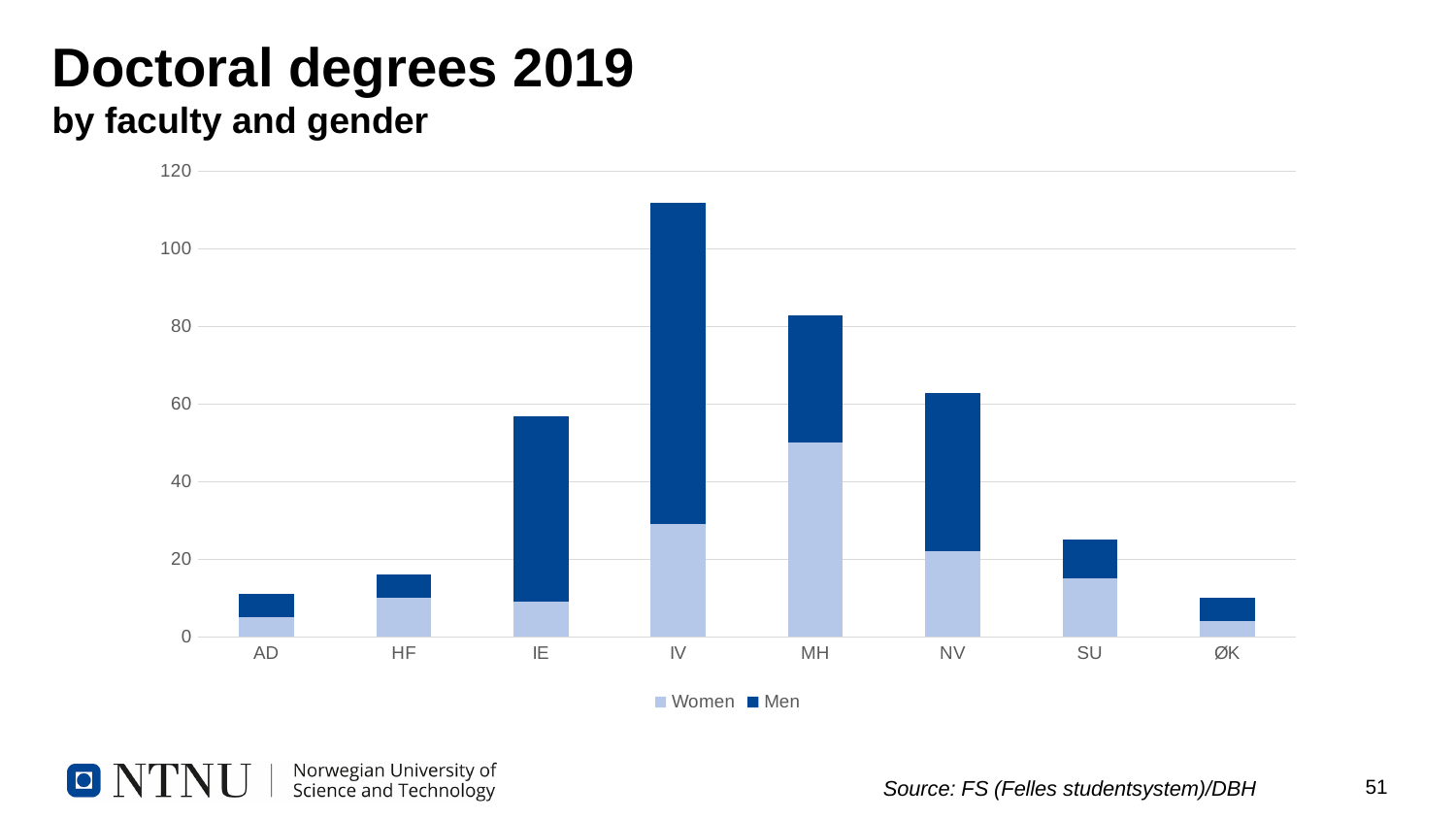
How many series does the legend list? 2 Which faculty has the highest total number of doctoral degrees? IV Which has the larger total number of doctoral degrees, MH or NV? MH Is the total value for IE greater or less than 40? greater Is the Women value for MH greater or less than 40? greater How many faculties are shown on the x axis? 8 What kind of chart is shown on the slide? Stacked bar chart Which faculty has the highest number of doctoral degrees awarded to women? MH What are the two series named in the legend? Women and Men Is the total value for IV greater or less than 100? greater Which faculty has more doctoral degrees awarded to men, IV or MH? IV